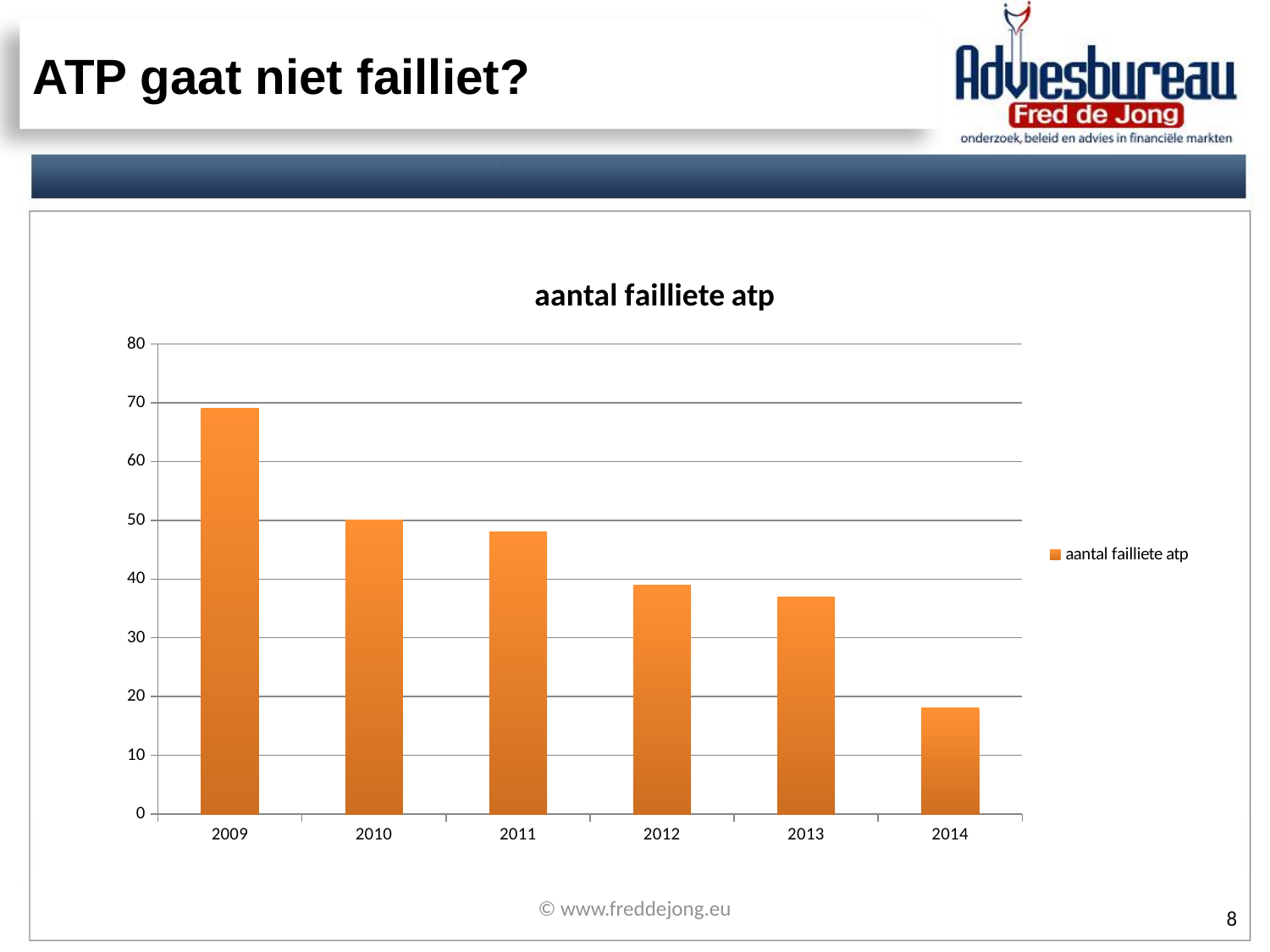
Is the value for 2009 greater or less than 60? greater Is the value for 2012 greater or less than 30? greater Which year has the highest number of failliete atp? 2009 What type of chart is shown on the slide? bar chart What is the title of the chart? aantal failliete atp How many years are shown on the x axis of the chart? 6 Is the value for 2013 greater or less than 40? less How many series does the legend list? 1 Which year has the lowest number of failliete atp? 2014 Do the values rise or fall from 2009 to 2014? fall Which year has a larger value, 2011 or 2013? 2011